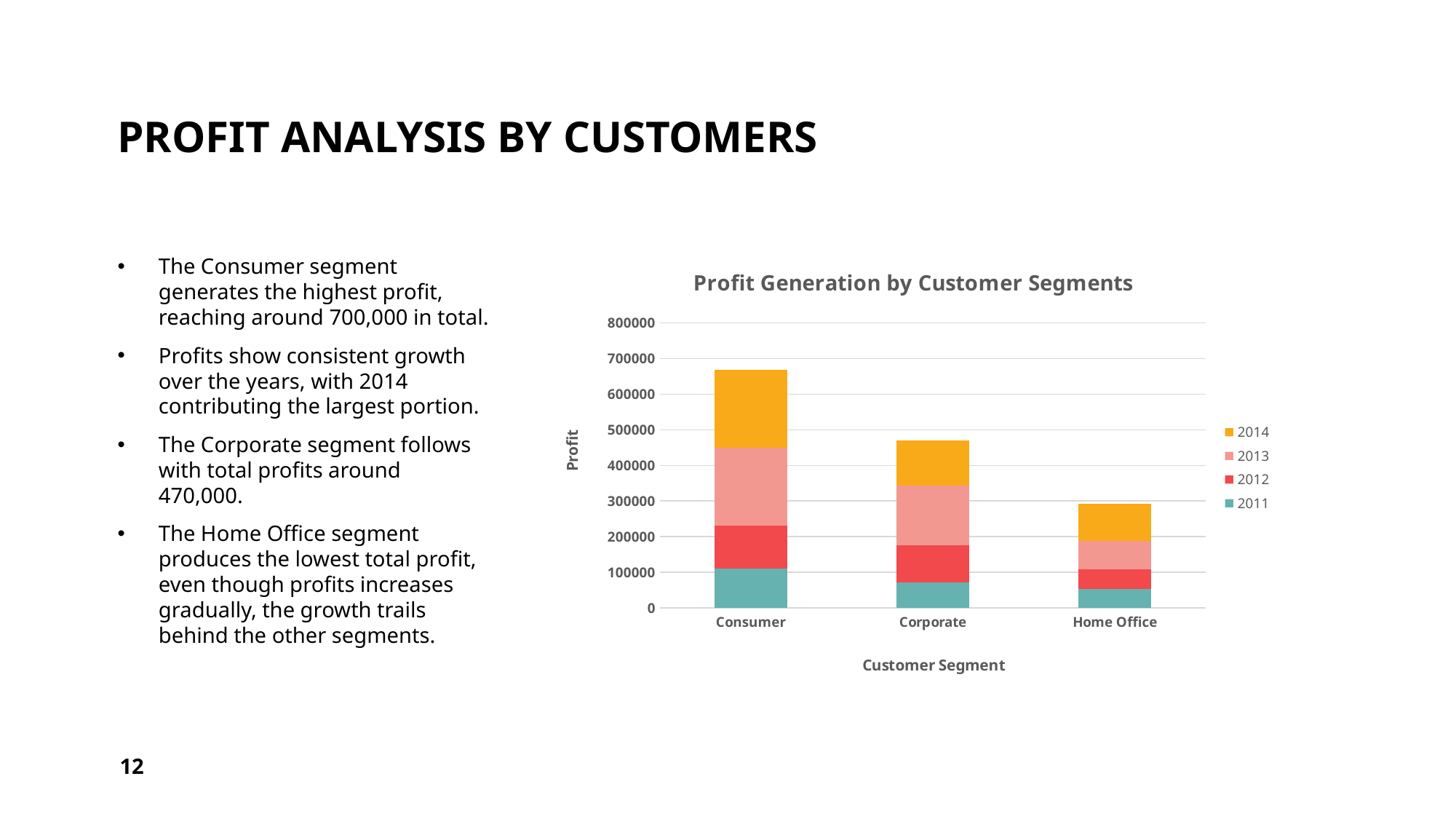
Which year is represented by the orange segments at the top of each bar? 2014 Is the total profit for Consumer greater or less than 700000? less What is the title of the chart? Profit Generation by Customer Segments Which customer segment has the lowest total profit in the chart? Home Office Is the total profit for Home Office greater or less than 200000? greater How many customer segments are shown on the x axis of the chart? 3 What kind of chart is shown on the slide? Stacked bar chart How many series does the chart legend list? 4 Is the total profit for Corporate greater or less than 500000? less Which has a larger total profit bar, Corporate or Home Office? Corporate Which customer segment has the highest total profit in the chart? Consumer